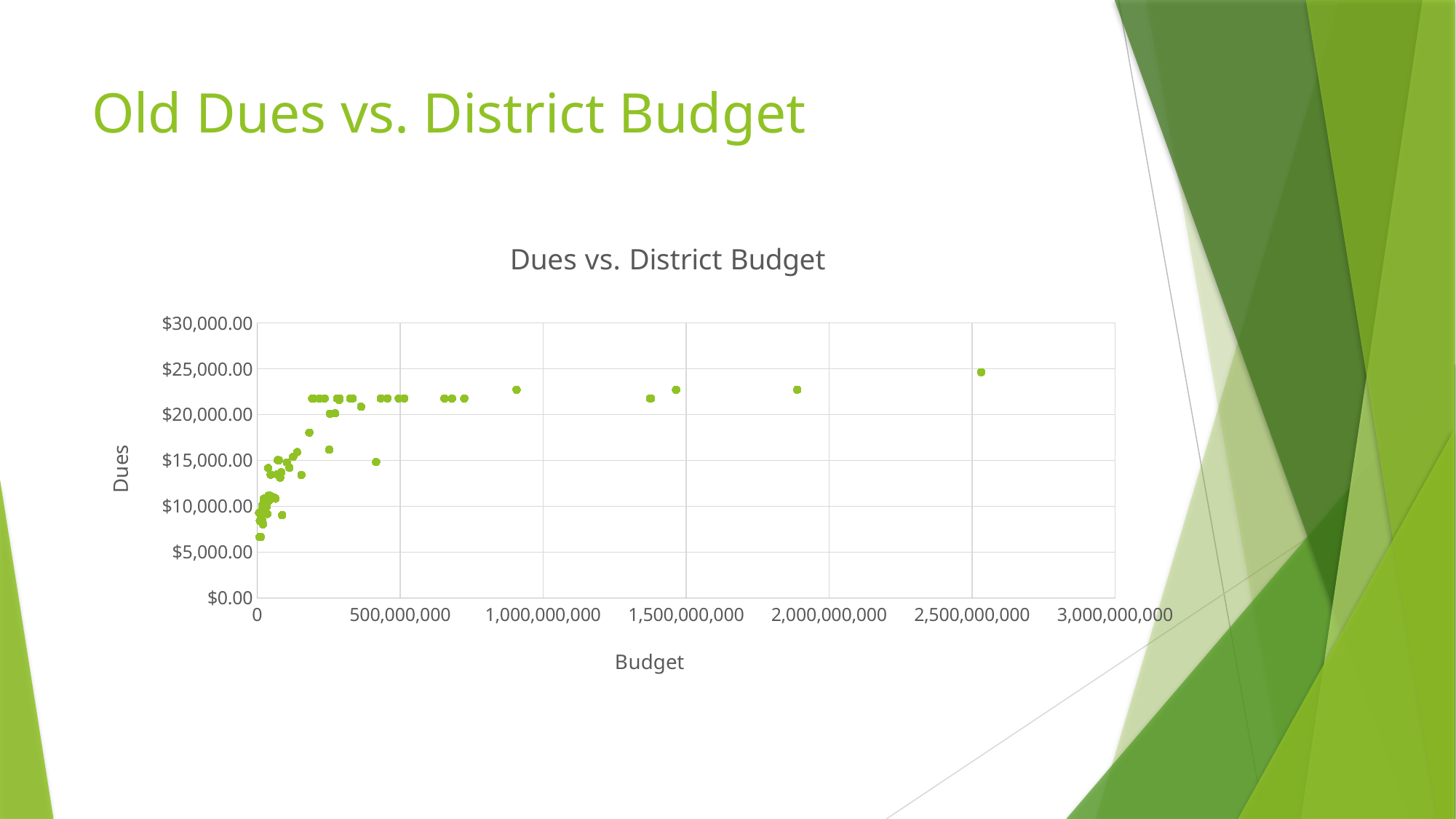
What kind of chart is shown on the slide? Scatter chart Is the lowest dues value plotted on the chart greater or less than $10,000.00? less What are the titles of the x axis and the y axis of the chart? Budget (x axis) and Dues (y axis) Is the dues value for the point with the smallest budget greater or less than $10,000.00? less Is the lowest dues value plotted on the chart greater or less than $5,000.00? greater As budget increases along the x axis, do dues generally rise or fall? Rise What is the title of the chart? Dues vs. District Budget Which point has higher dues: the one with a budget near 2,500,000,000 or the one with a budget near 1,500,000,000? The one near 2,500,000,000 What is the highest value shown on the y axis? $30,000.00